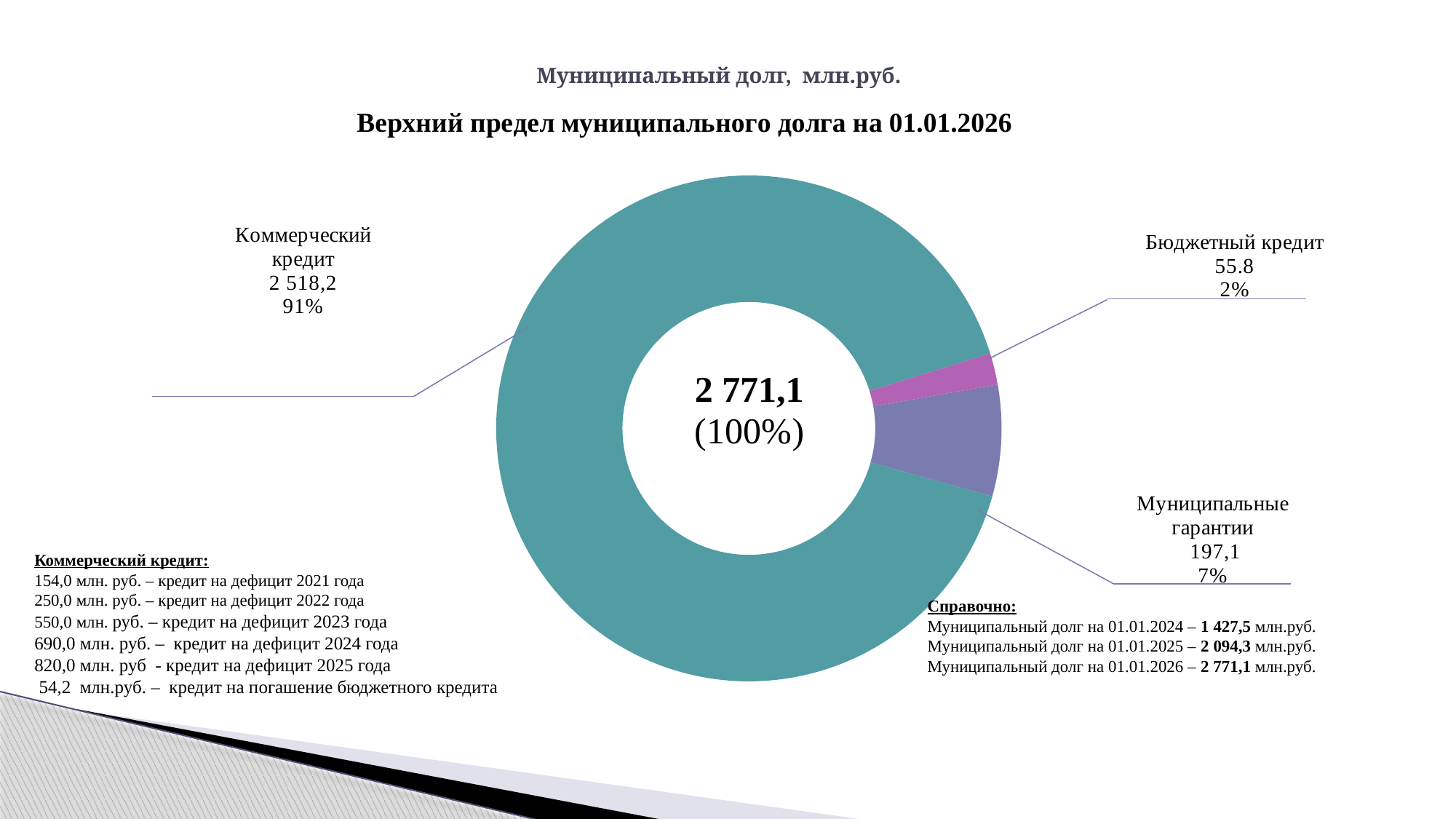
Which category has the smallest value? Бюджетный кредит What is the value for Муниципальные гарантии? 197,1 What share of the total does Бюджетный кредит represent? 2% How many categories does the chart show? 3 What kind of chart is shown on the slide? Donut (pie) chart Which is larger, Муниципальные гарантии or Бюджетный кредит? Муниципальные гарантии What share of the total does Муниципальные гарантии represent? 7% What is the value for Коммерческий кредит? 2 518,2 What share of the total does Коммерческий кредит represent? 91% What is the value for Бюджетный кредит? 55.8 What total value is shown in the centre of the chart? 2 771,1 Which category has the largest value? Коммерческий кредит